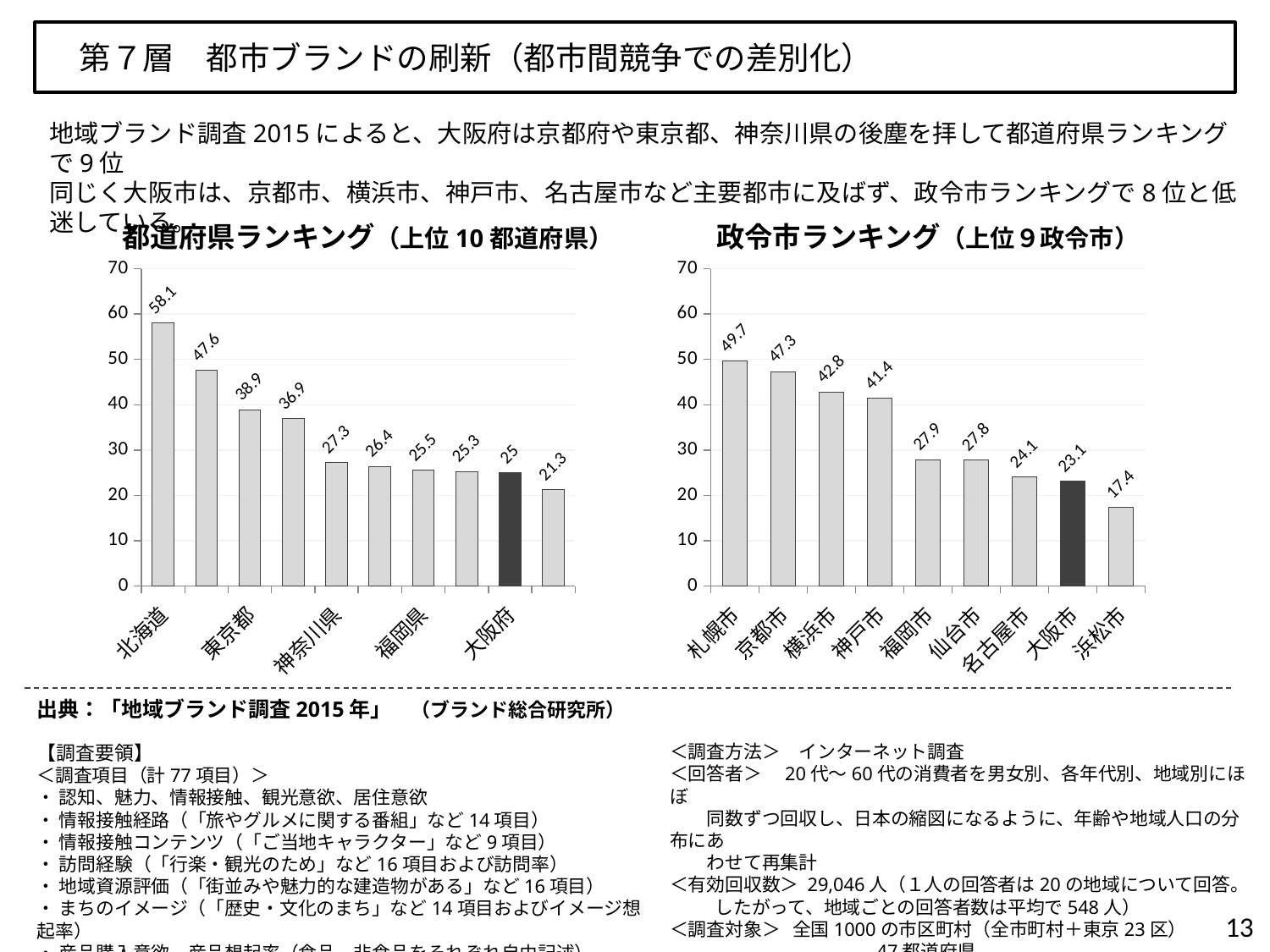
In the 政令市ランキング chart on the right, what is the difference between the values for 京都市 and 大阪市? 24.2 In the 政令市ランキング chart on the right, which has the larger value, 横浜市 or 神戸市? 横浜市 In the 政令市ランキング chart on the right, how many cities are plotted? 9 In the 都道府県ランキング chart on the left, what is the value for 大阪府? 25 In the 政令市ランキング chart on the right, which city has the lowest value? 浜松市 In the 都道府県ランキング chart on the left, what is the difference between the values for 北海道 and 大阪府? 33.1 In the 政令市ランキング chart on the right, which city has the highest value? 札幌市 In the 政令市ランキング chart on the right, what is the value for 札幌市? 49.7 In the 政令市ランキング chart on the right, what is the value for 大阪市? 23.1 In the 都道府県ランキング chart on the left, what is the value for 北海道? 58.1 What kind of chart is the 都道府県ランキング chart on the left? bar chart In the 政令市ランキング chart on the right, is the value for 浜松市 greater or less than 20? less